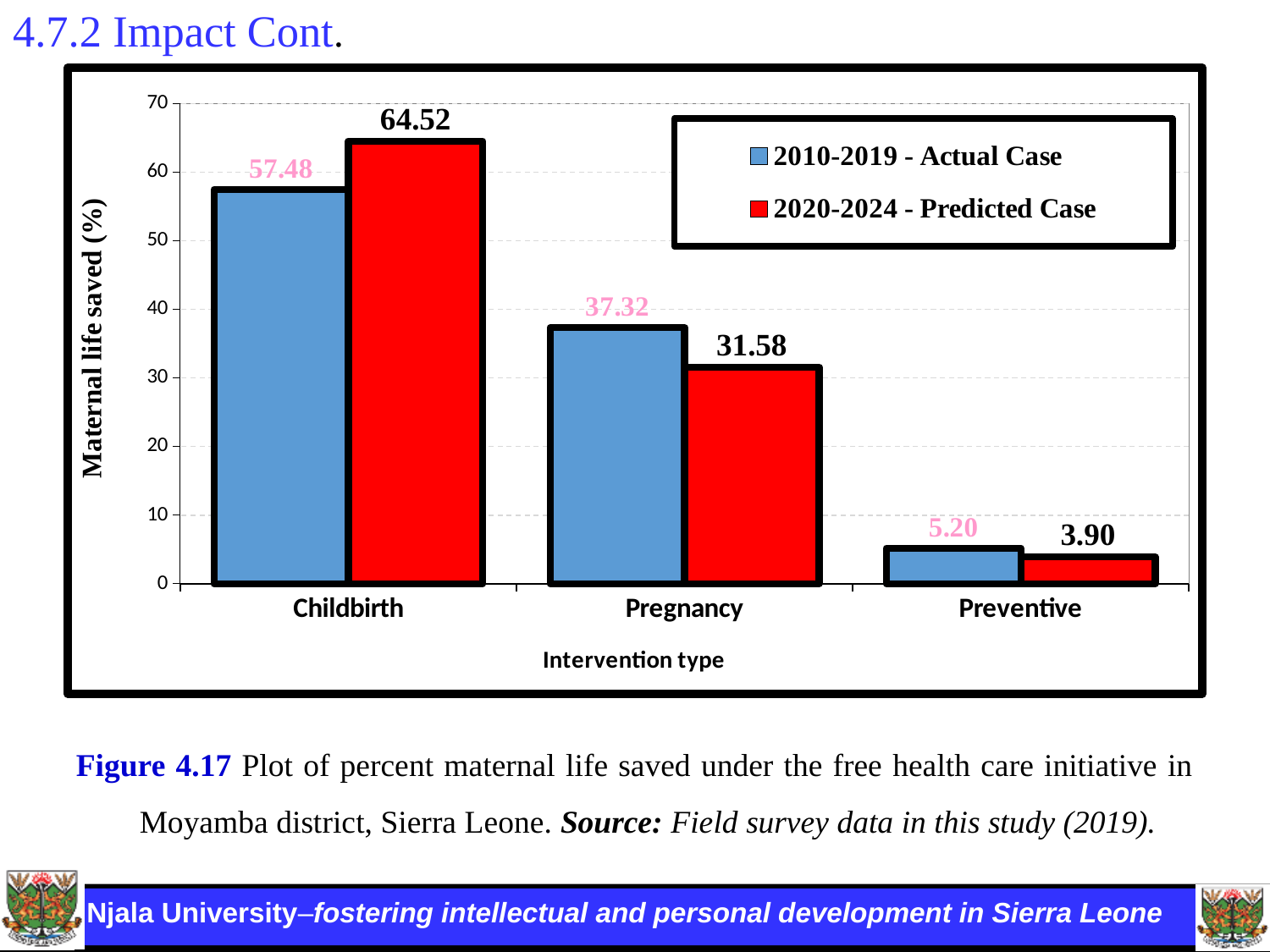
Which intervention type has the lowest value in the 2010-2019 - Actual Case series? Preventive Which intervention type has the highest value in the 2020-2024 - Predicted Case series? Childbirth What is the difference between the 2020-2024 - Predicted Case and 2010-2019 - Actual Case values for Childbirth? 7.04 How many series does the legend list? 2 What kind of chart is shown on the slide? Bar chart What is the value for Preventive in the 2010-2019 - Actual Case series? 5.20 What is the difference between the 2010-2019 - Actual Case and 2020-2024 - Predicted Case values for Pregnancy? 5.74 For Preventive, which series has the larger value: 2010-2019 - Actual Case or 2020-2024 - Predicted Case? 2010-2019 - Actual Case What is the value for Pregnancy in the 2020-2024 - Predicted Case series? 31.58 What is the label of the y axis? Maternal life saved (%) What is the value for Childbirth in the 2010-2019 - Actual Case series? 57.48 How many intervention types are shown on the x axis? 3